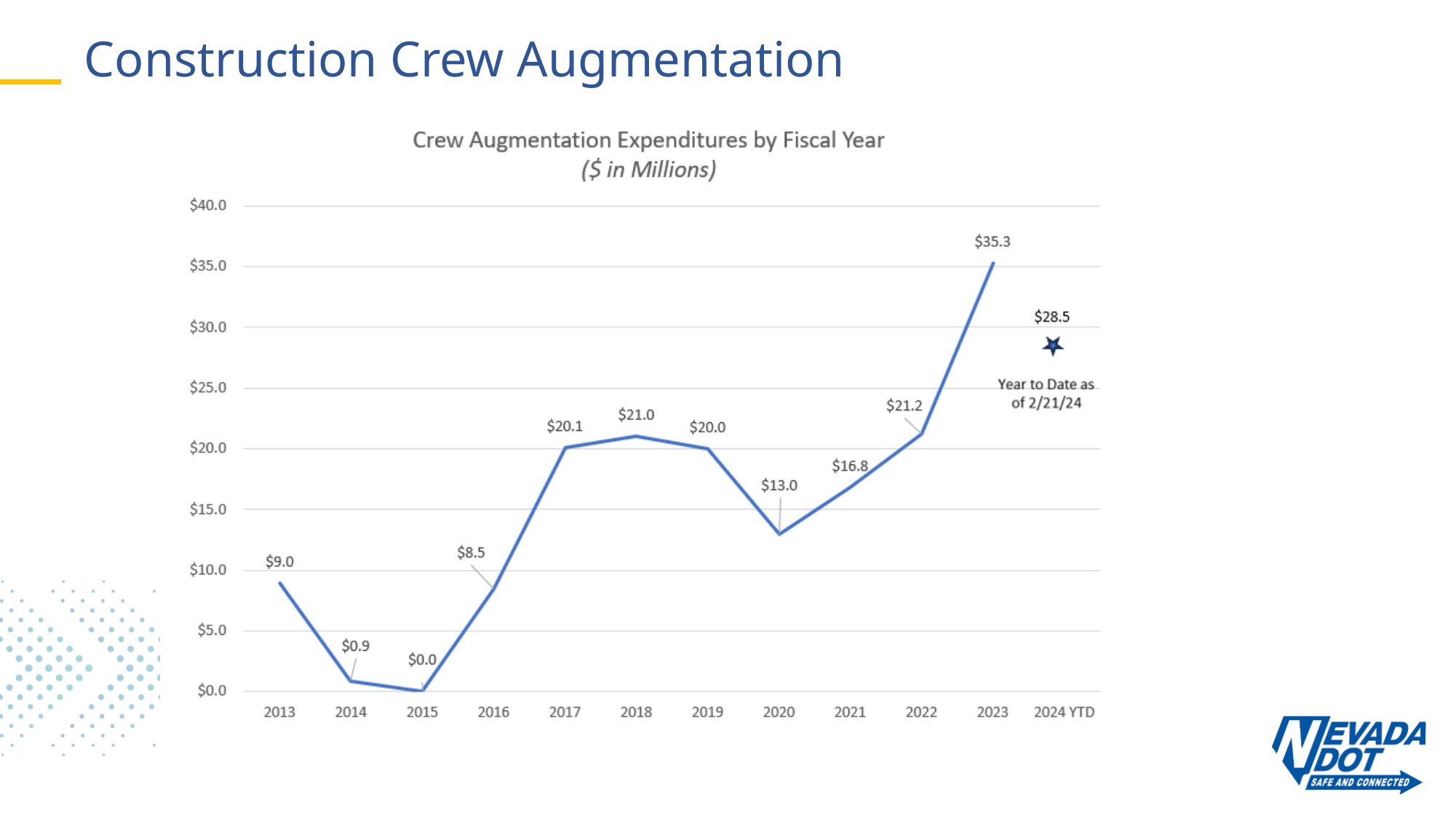
Did crew augmentation expenditures rise or fall from 2013 to 2015? Fall Which fiscal year had the highest crew augmentation expenditure? 2023 How many fiscal year categories are shown on the x axis? 12 What is the title of the chart? Crew Augmentation Expenditures by Fiscal Year ($ in Millions) What kind of chart is shown on the slide? Line chart What was the crew augmentation expenditure in fiscal year 2020? $13.0 Which fiscal year had the lowest crew augmentation expenditure? 2015 What is the 2024 YTD crew augmentation expenditure shown on the chart? $28.5 What is the difference between the 2023 and 2022 crew augmentation expenditures? $14.1 As of what date is the 2024 YTD value reported? 2/21/24 Which year had a higher expenditure, 2018 or 2019? 2018 What was the crew augmentation expenditure in fiscal year 2017? $20.1